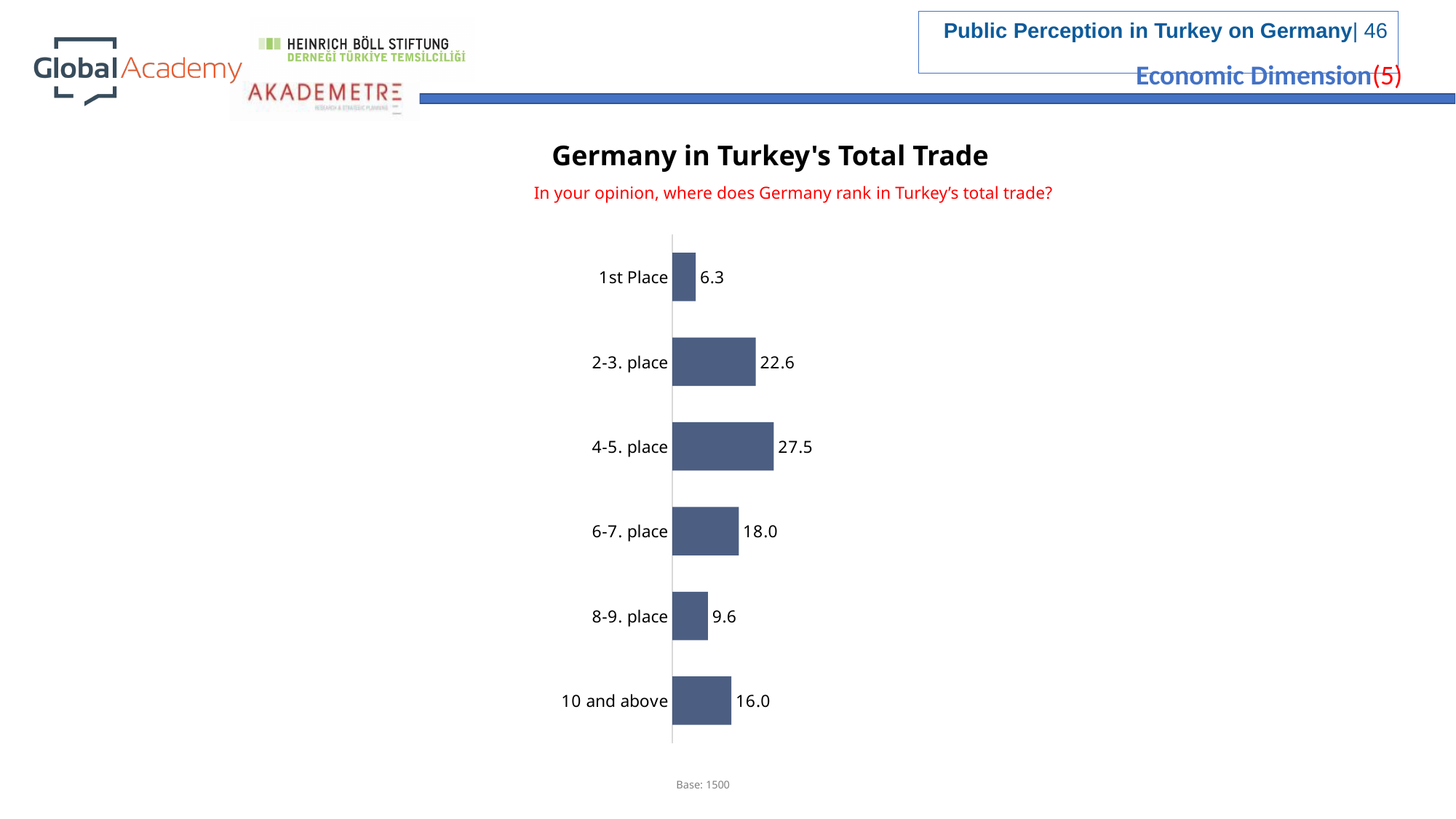
What is the value for '10 and above'? 16.0 Which category has the lowest value? 1st Place What kind of chart is shown on the slide? Bar chart How many categories are shown in the chart? 6 Which is larger, the value for '2-3. place' or the value for '6-7. place'? 2-3. place What is the value for '1st Place'? 6.3 What is the difference between the values for '4-5. place' and '2-3. place'? 4.9 What is the title of the chart? Germany in Turkey's Total Trade What is the value for '8-9. place'? 9.6 Which category has the highest value? 4-5. place What is the value for '4-5. place'? 27.5 What is the difference between the values for '6-7. place' and '10 and above'? 2.0